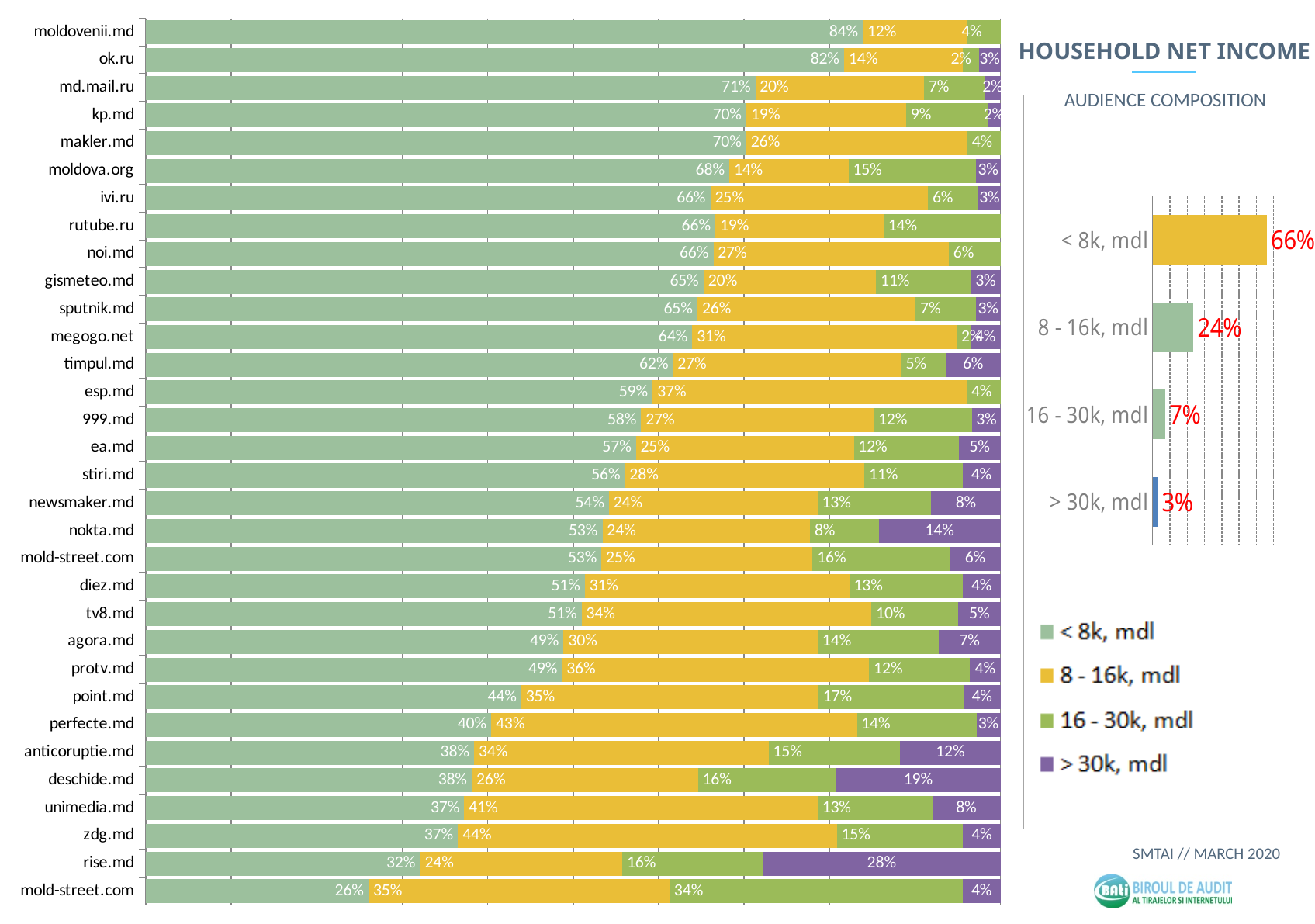
In the main stacked bar chart, what percentage of moldovenii.md's audience has a household net income below 8k mdl? 84% How many websites are listed in the main stacked bar chart? 32 In the small Household Net Income chart on the right, what is the value for 8 - 16k, mdl? 24% In the main stacked bar chart, what share of rise.md's audience is in the > 30k, mdl income group? 28% In the main stacked bar chart, how many percentage points higher is the > 30k, mdl share for rise.md than for deschide.md? 9 percentage points In the main stacked bar chart, what is the 8 - 16k, mdl share for zdg.md? 44% In the main stacked bar chart, which website has the highest share of audience in the > 30k, mdl income group? rise.md What type of chart is the main chart on the slide? Stacked bar chart How many income groups does the legend of the main chart list? 4 In the main stacked bar chart, which website has the highest share of audience with income below 8k mdl? moldovenii.md In the small Household Net Income chart on the right, which income group has the lowest value? > 30k, mdl In the main stacked bar chart, for perfecte.md, which is larger: the < 8k, mdl share or the 8 - 16k, mdl share? 8 - 16k, mdl